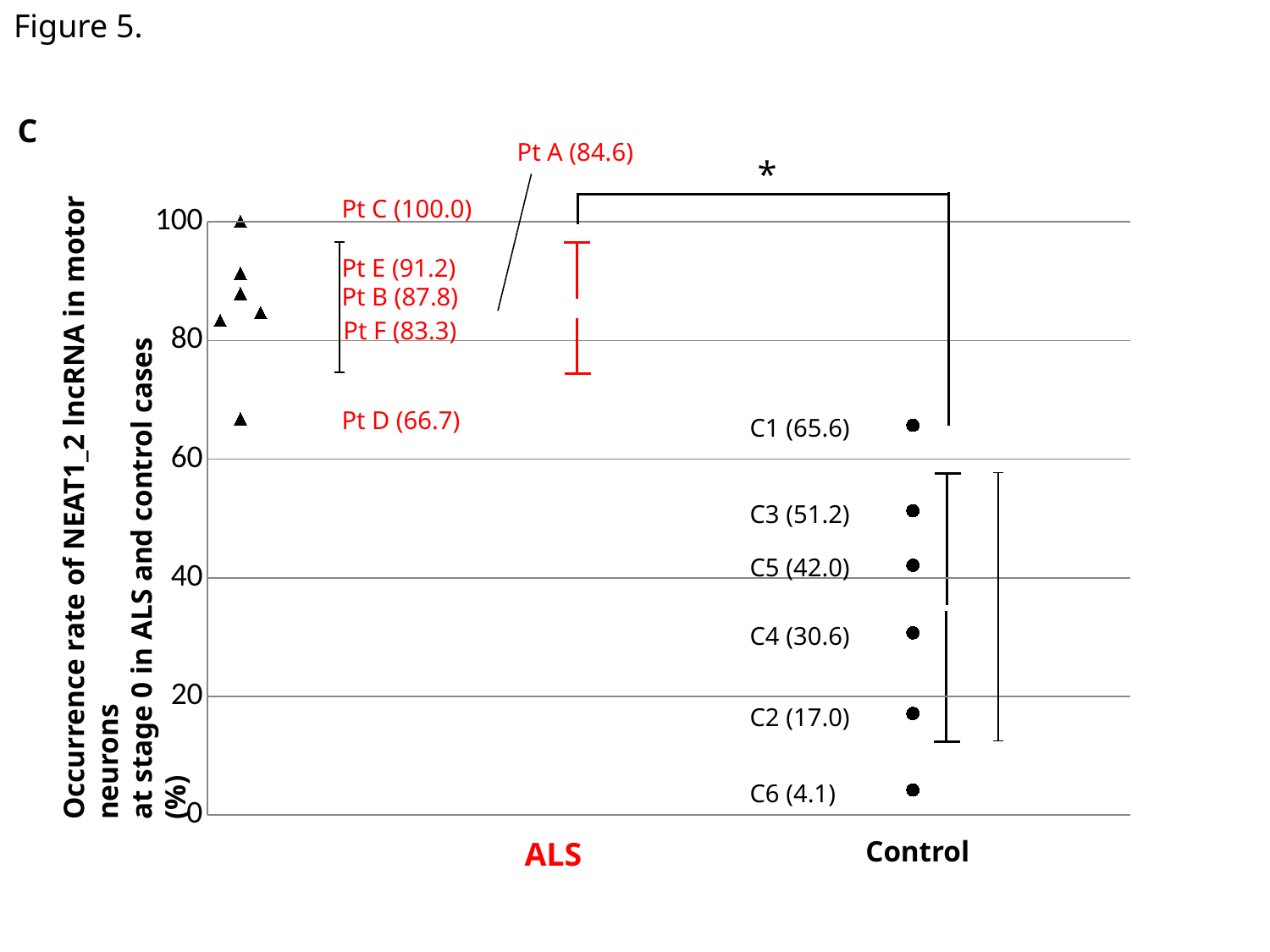
What is the difference between the values for Pt C and Pt D? 33.3 What is the difference between the values for C1 and C6? 61.5 Which ALS patient has the highest occurrence rate? Pt C What is the value printed for Pt D? 66.7 Is the value for C3 greater or less than 60? less What are the two groups labelled on the x axis? ALS and Control What is the occurrence rate value printed for Pt C in the ALS group? 100.0 Which control case has the lowest occurrence rate? C6 Which ALS patient has the lowest occurrence rate? Pt D How many control cases are plotted in the Control group? 6 Which has the larger value, Pt E or Pt B? Pt E What is the value printed for C6 in the Control group? 4.1